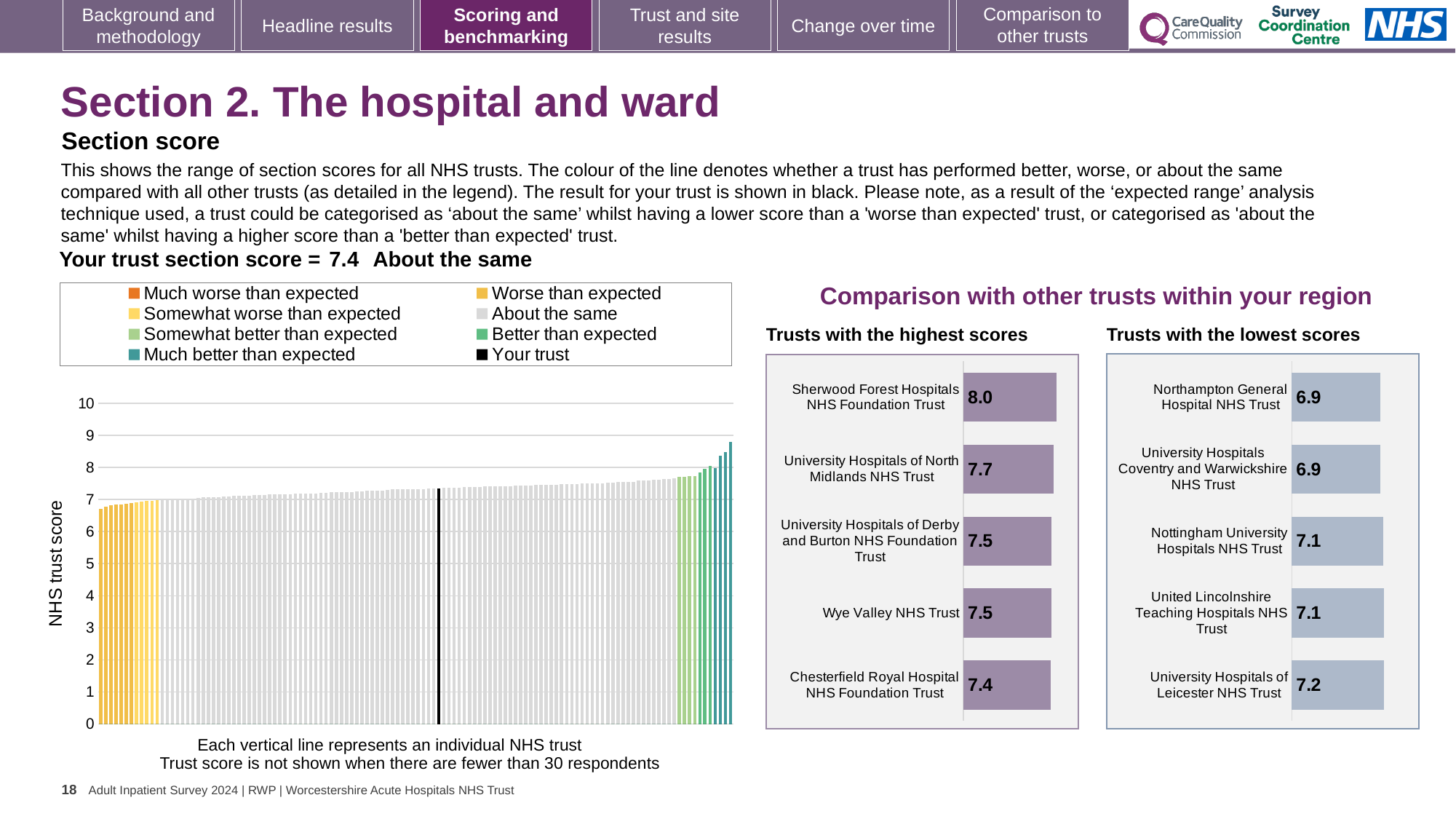
How many trusts are shown in the 'Trusts with the highest scores' chart? 5 In the 'Trusts with the lowest scores' chart, which trust has the highest score? University Hospitals of Leicester NHS Trust In the main NHS trust score chart, is the value for the black 'Your trust' bar greater or less than 7? greater In the 'Trusts with the highest scores' chart, what is the score for Sherwood Forest Hospitals NHS Foundation Trust? 8.0 In the 'Trusts with the highest scores' chart, what is the difference between the scores of Sherwood Forest Hospitals NHS Foundation Trust and Chesterfield Royal Hospital NHS Foundation Trust? 0.6 What kind of chart is the main chart showing NHS trust scores on the left of the slide? bar chart In the 'Trusts with the highest scores' chart, which has the larger score: University Hospitals of North Midlands NHS Trust or Wye Valley NHS Trust? University Hospitals of North Midlands NHS Trust In the 'Trusts with the lowest scores' chart, what is the difference between the scores of University Hospitals of Leicester NHS Trust and Northampton General Hospital NHS Trust? 0.3 In the 'Trusts with the highest scores' chart, what is the score for Chesterfield Royal Hospital NHS Foundation Trust? 7.4 In the 'Trusts with the highest scores' chart, which trust has the highest score? Sherwood Forest Hospitals NHS Foundation Trust In the 'Trusts with the lowest scores' chart, what is the score for Nottingham University Hospitals NHS Trust? 7.1 How many entries does the legend of the main NHS trust score chart list? 8